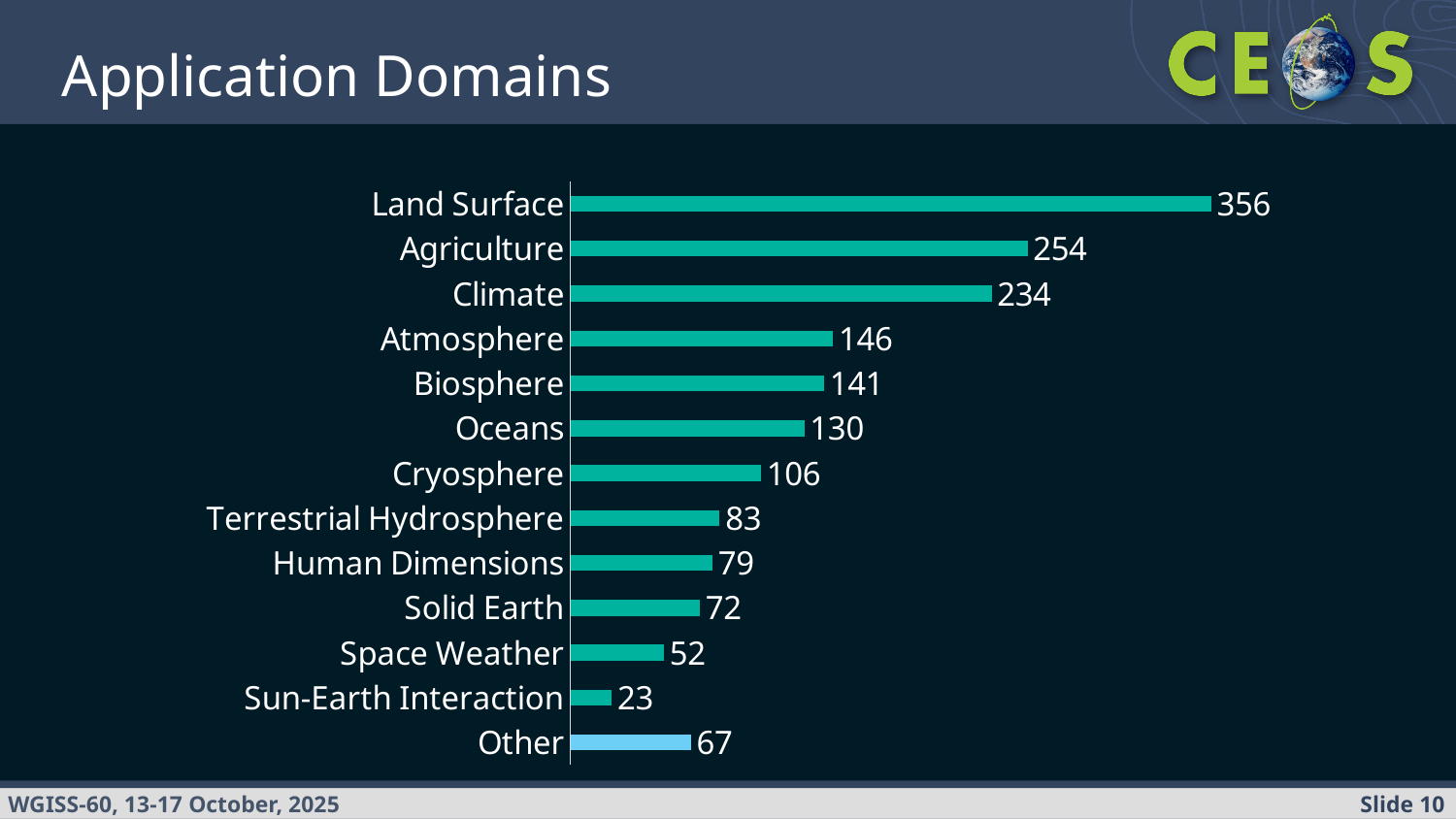
How many categories are shown in the chart? 13 Which category has the highest value? Land Surface What is the value for Cryosphere? 106 Which category has the lowest value? Sun-Earth Interaction What is the value for Space Weather? 52 Which is larger, the value for Oceans or the value for Terrestrial Hydrosphere? Oceans Which is larger, the value for Solid Earth or the value for Human Dimensions? Human Dimensions What kind of chart is shown on the slide? Bar chart Which bar is shown in a different colour from the others? Other What is the difference between the values for Land Surface and Other? 289 What is the value for Land Surface? 356 What is the difference between the values for Agriculture and Climate? 20